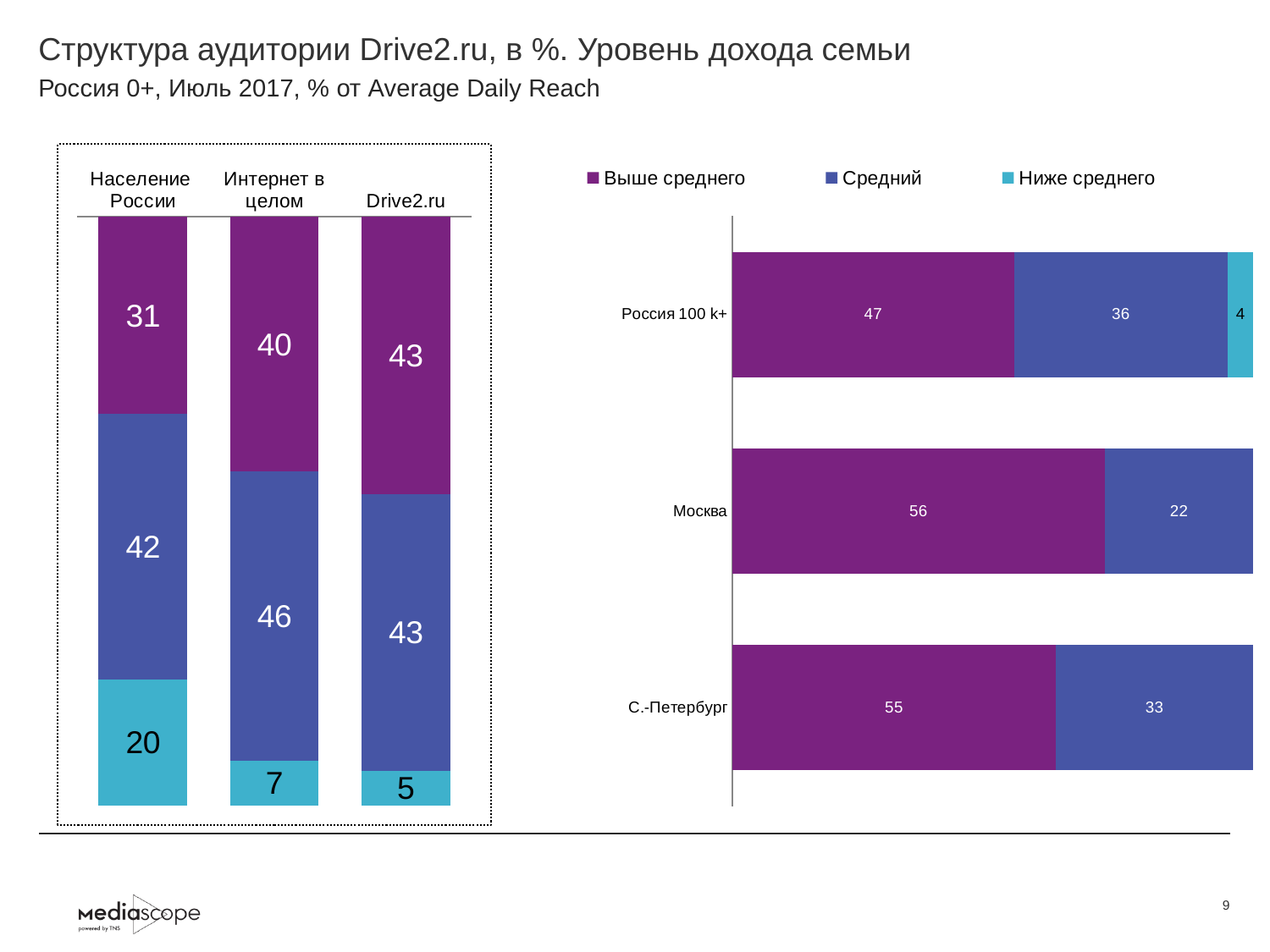
In the right chart, what is the difference between 'Выше среднего' and 'Средний' for С.-Петербург? 22 In the right chart, what is the value of 'Ниже среднего' for Россия 100 k+? 4 In the right chart, which has a larger 'Выше среднего' value, Москва or С.-Петербург? Москва In the left chart, what is the difference between 'Средний' and 'Ниже среднего' for Интернет в целом? 39 How many series does the legend list? 3 In the left chart, what is the value of 'Выше среднего' for Drive2.ru? 43 In the right chart, which category has the lowest value for 'Средний'? Москва In the left chart, which category has the highest value for 'Ниже среднего'? Население России In the left chart, what is the value of 'Ниже среднего' for Население России? 20 How many categories are shown in the right chart? 3 In the right chart, what is the value of 'Выше среднего' for Москва? 56 In the left chart, what is the total of the stacked bar for Население России? 93